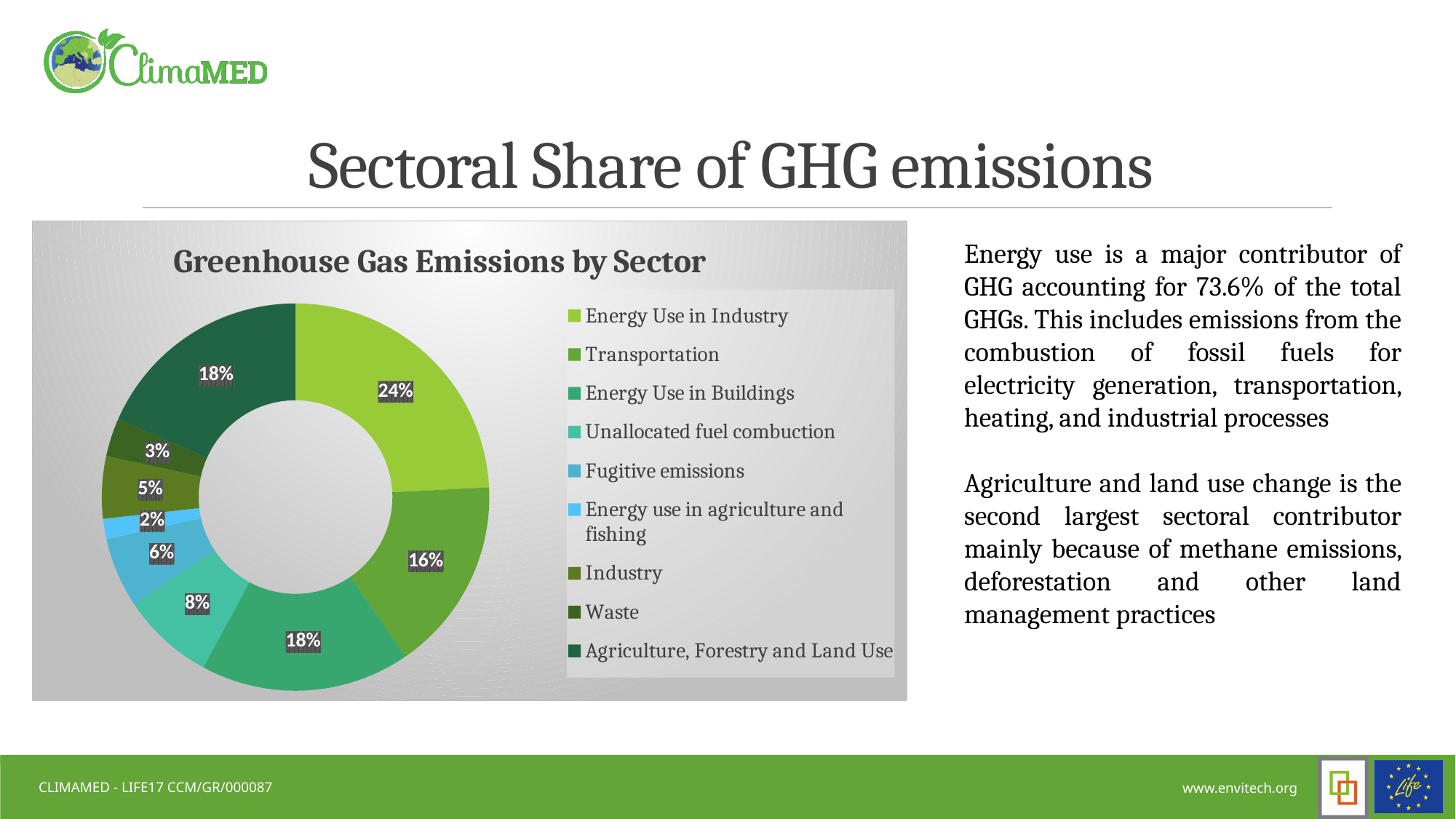
Which has a larger share, Industry or Unallocated fuel combuction? Unallocated fuel combuction What is the combined share of Energy Use in Buildings and Agriculture, Forestry and Land Use? 36% What is the difference in percentage points between Energy Use in Industry and Transportation? 8 What percentage of emissions is attributed to Transportation? 16% What is the title of the chart? Greenhouse Gas Emissions by Sector What share of greenhouse gas emissions does Energy Use in Industry account for? 24% What share does Fugitive emissions hold in the chart? 6% What is the share for Waste? 3% Which sector has the largest share of greenhouse gas emissions? Energy Use in Industry What type of chart is used to show Greenhouse Gas Emissions by Sector? Doughnut chart Which sector has the smallest share of greenhouse gas emissions? Energy use in agriculture and fishing How many sectors are shown in the chart? 9